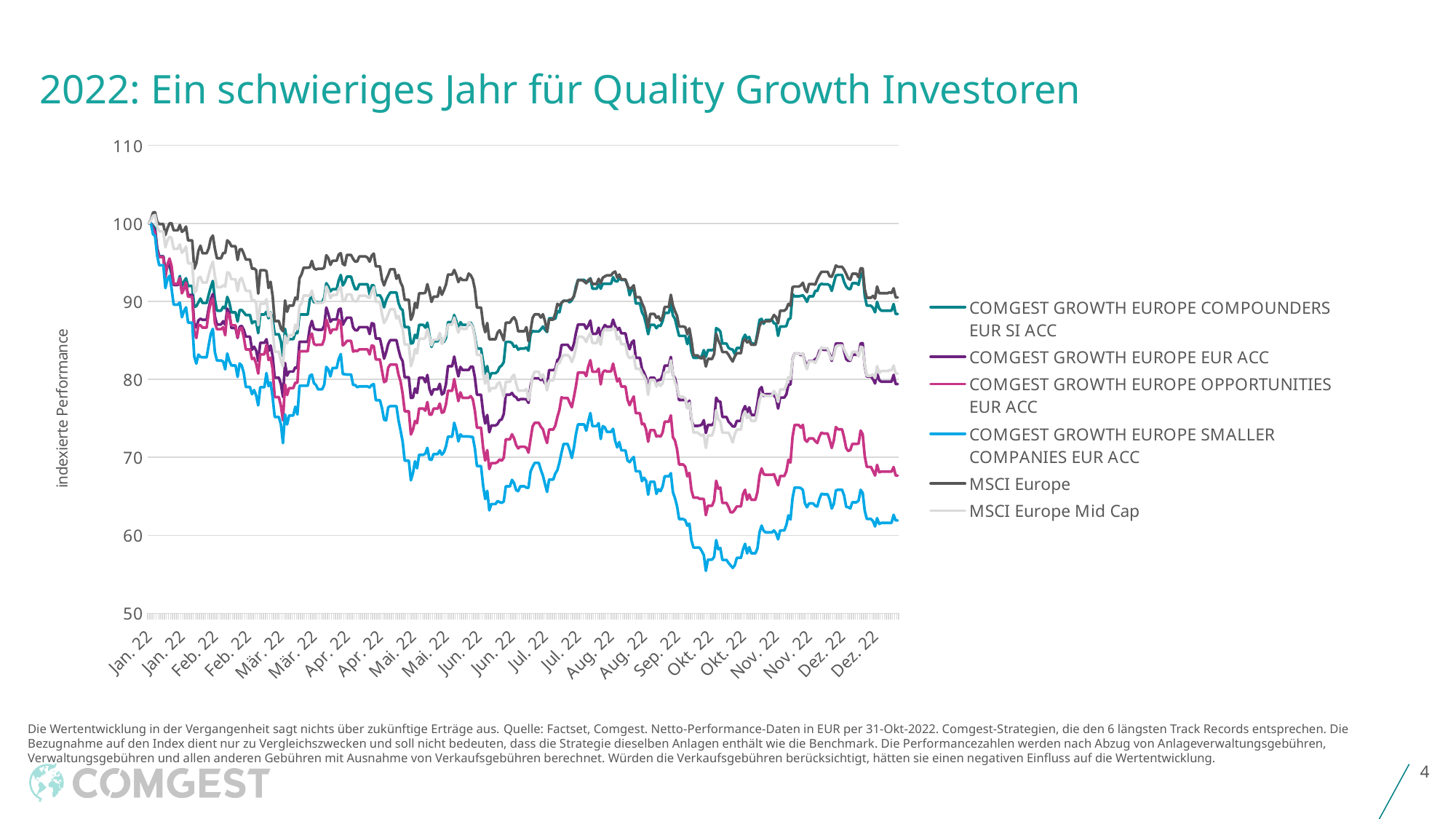
Which series has the lowest value at the end of Dez. 22? COMGEST GROWTH EUROPE SMALLER COMPANIES EUR ACC How many series does the legend list? 6 At what value do all series start in Jan. 22? 100 What kind of chart is shown on the slide? line chart Is the lowest value reached by COMGEST GROWTH EUROPE SMALLER COMPANIES EUR ACC in Okt. 22 greater or less than 60? less Is the value for MSCI Europe at the end of Dez. 22 greater or less than 80? greater What is the title of the slide? 2022: Ein schwieriges Jahr für Quality Growth Investoren Is the value for COMGEST GROWTH EUROPE SMALLER COMPANIES EUR ACC at the end of Dez. 22 greater or less than 70? less What is the label on the y axis? indexierte Performance At the end of Dez. 22, which is larger: COMGEST GROWTH EUROPE OPPORTUNITIES EUR ACC or COMGEST GROWTH EUROPE SMALLER COMPANIES EUR ACC? COMGEST GROWTH EUROPE OPPORTUNITIES EUR ACC Which series has the highest value at the end of Dez. 22? MSCI Europe Do the series generally rise or fall from Jan. 22 to Dez. 22? fall